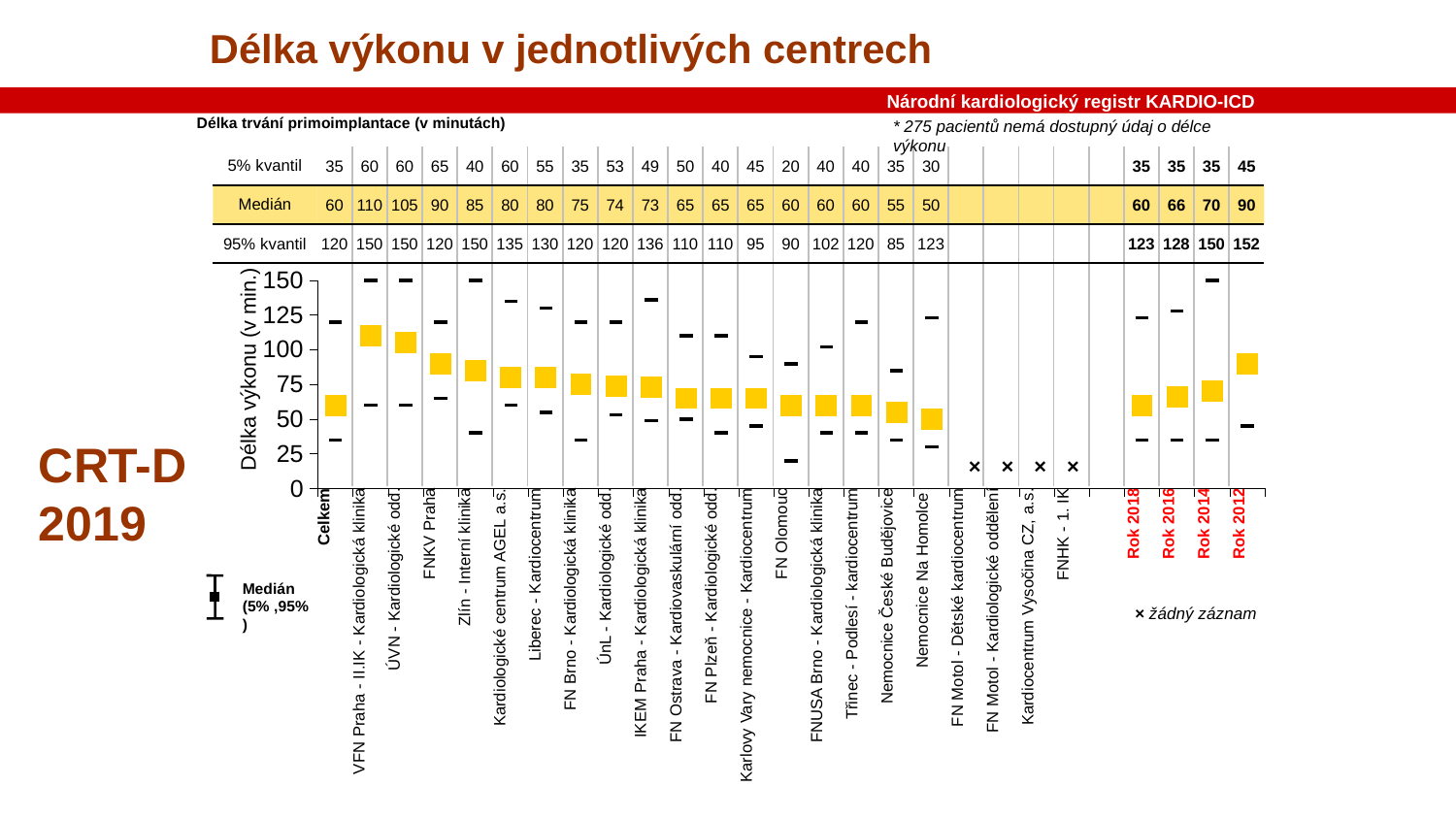
Which category has the highest 95% kvantil value? Rok 2012 How many centres are marked with × (žádný záznam, no record)? 4 What is the median (Medián) procedure duration for VFN Praha - II.IK - Kardiologická klinika? 110 Which has the larger median: FNKV Praha or Zlín - Interní klinika? FNKV Praha Moving along the x axis from Rok 2018 to Rok 2012, does the median rise or fall? rise What is the 5% kvantil value for FN Olomouc? 20 What is the 95% kvantil value for IKEM Praha - Kardiologická klinika? 136 Which centre has the highest median procedure duration? VFN Praha - II.IK - Kardiologická klinika Which centre has the lowest median procedure duration? Nemocnice Na Homolce What is the median (Medián) value for Celkem? 60 What is the label of the y axis? Délka výkonu (v min.) What is the difference between the median for Rok 2012 and the median for Rok 2018? 30